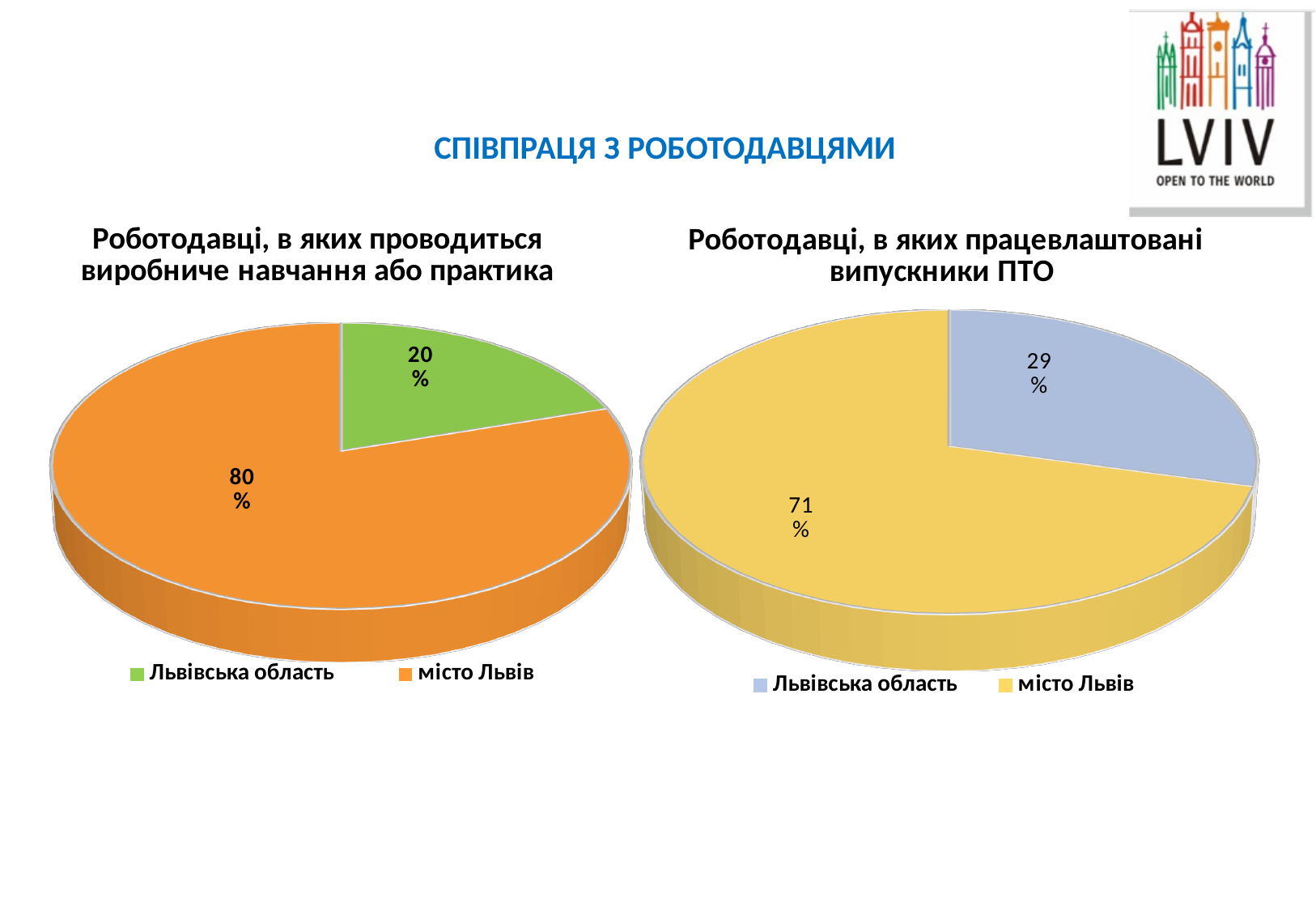
Which is larger: the share of Львівська область in the left chart or in the right chart? the right chart (29%) What type of chart is the left chart? pie chart In the left chart (Роботодавці, в яких проводиться виробниче навчання або практика), what share is shown for Львівська область? 20% In the right chart (Роботодавці, в яких працевлаштовані випускники ПТО), what share is shown for Львівська область? 29% In the right chart, which category has the smallest slice? Львівська область How many categories does the legend of the right chart list? 2 In the left chart, which category has the largest slice? місто Львів In the left chart (Роботодавці, в яких проводиться виробниче навчання або практика), what share is shown for місто Львів? 80% In the left chart, what is the difference between the shares of місто Львів and Львівська область? 60% In the right chart (Роботодавці, в яких працевлаштовані випускники ПТО), what share is shown for місто Львів? 71% In the right chart, what is the difference between the shares of місто Львів and Львівська область? 42% What is the title of the right chart? Роботодавці, в яких працевлаштовані випускники ПТО